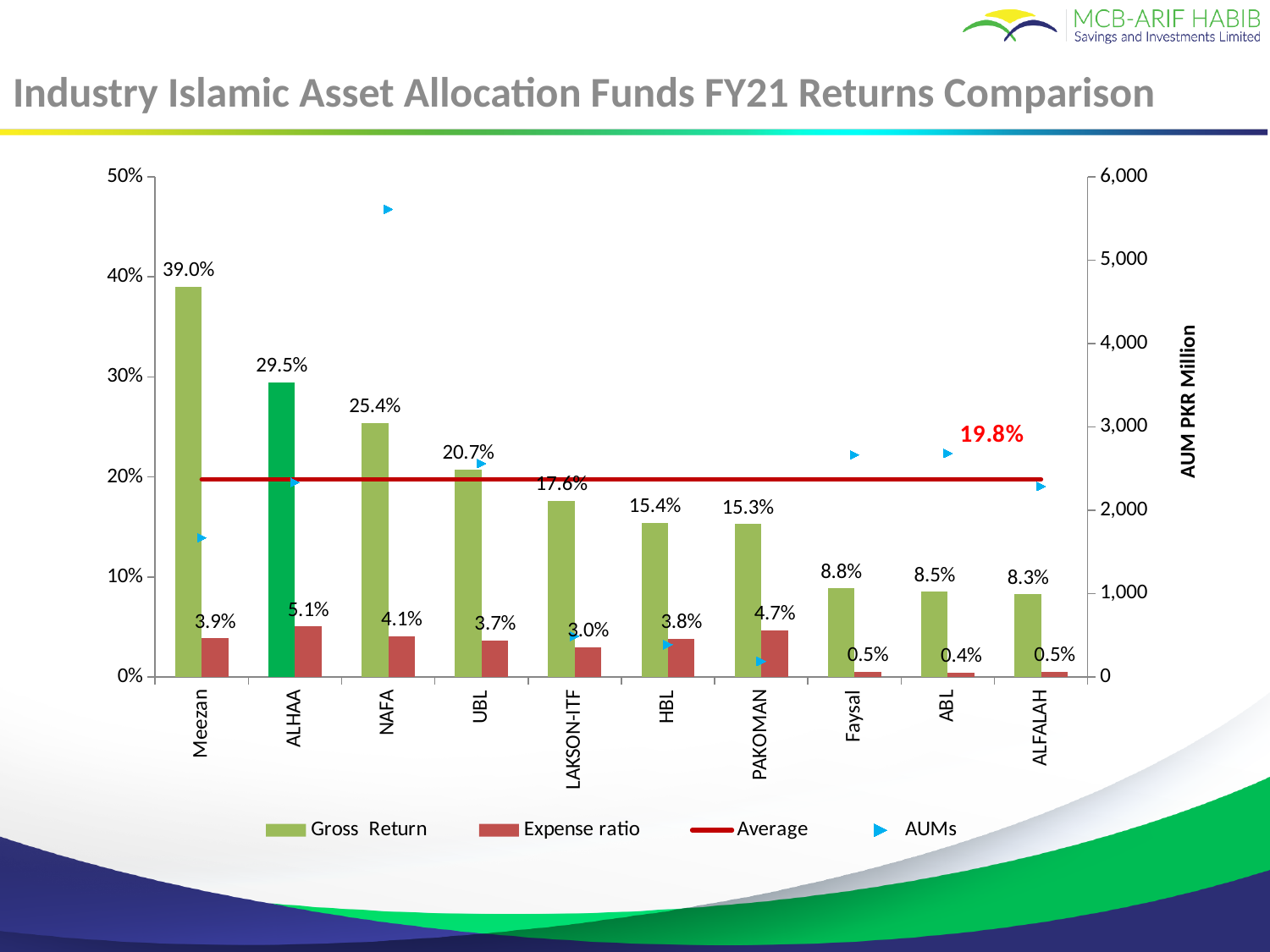
What is the label of the right-hand vertical axis? AUM PKR Million What is the difference between the Gross Return of Meezan and ALHAA? 9.5% Which has a higher Gross Return, NAFA or UBL? NAFA What is the Expense ratio for ALHAA? 5.1% Is the AUM value for NAFA greater or less than 5,000? greater Which fund has the lowest Expense ratio? ABL Which fund has the highest Gross Return? Meezan How many series does the legend list? 4 What value is shown for the Average line? 19.8% What is the Gross Return for Meezan? 39.0% Is the AUM value for Meezan greater or less than 2,000? less How many funds are shown on the x axis? 10